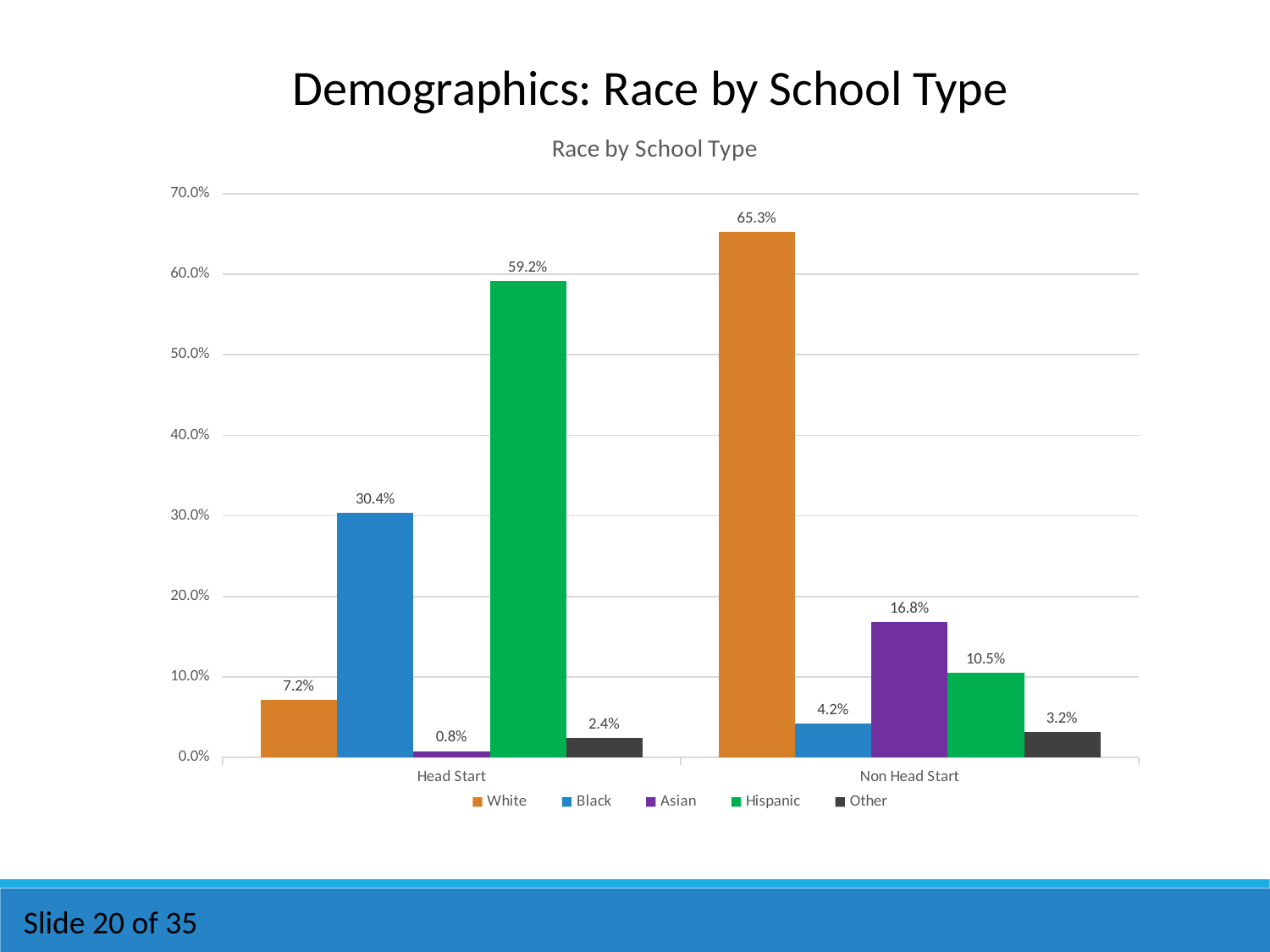
Which race has the highest value in the Head Start category? Hispanic What kind of chart is shown on the slide? Bar chart What is the title of the chart? Race by School Type What is the value for Hispanic in the Head Start category? 59.2% What is the value for Asian in the Head Start category? 0.8% How many school type categories are shown on the x axis? 2 What is the value for Black in the Non Head Start category? 4.2% Which race has the lowest value in the Non Head Start category? Other What is the value for White in the Non Head Start category? 65.3% How many series does the legend list? 5 What is the difference between the White values for Non Head Start and Head Start? 58.1% Which is larger: the Black value for Head Start or the Asian value for Non Head Start? Black value for Head Start